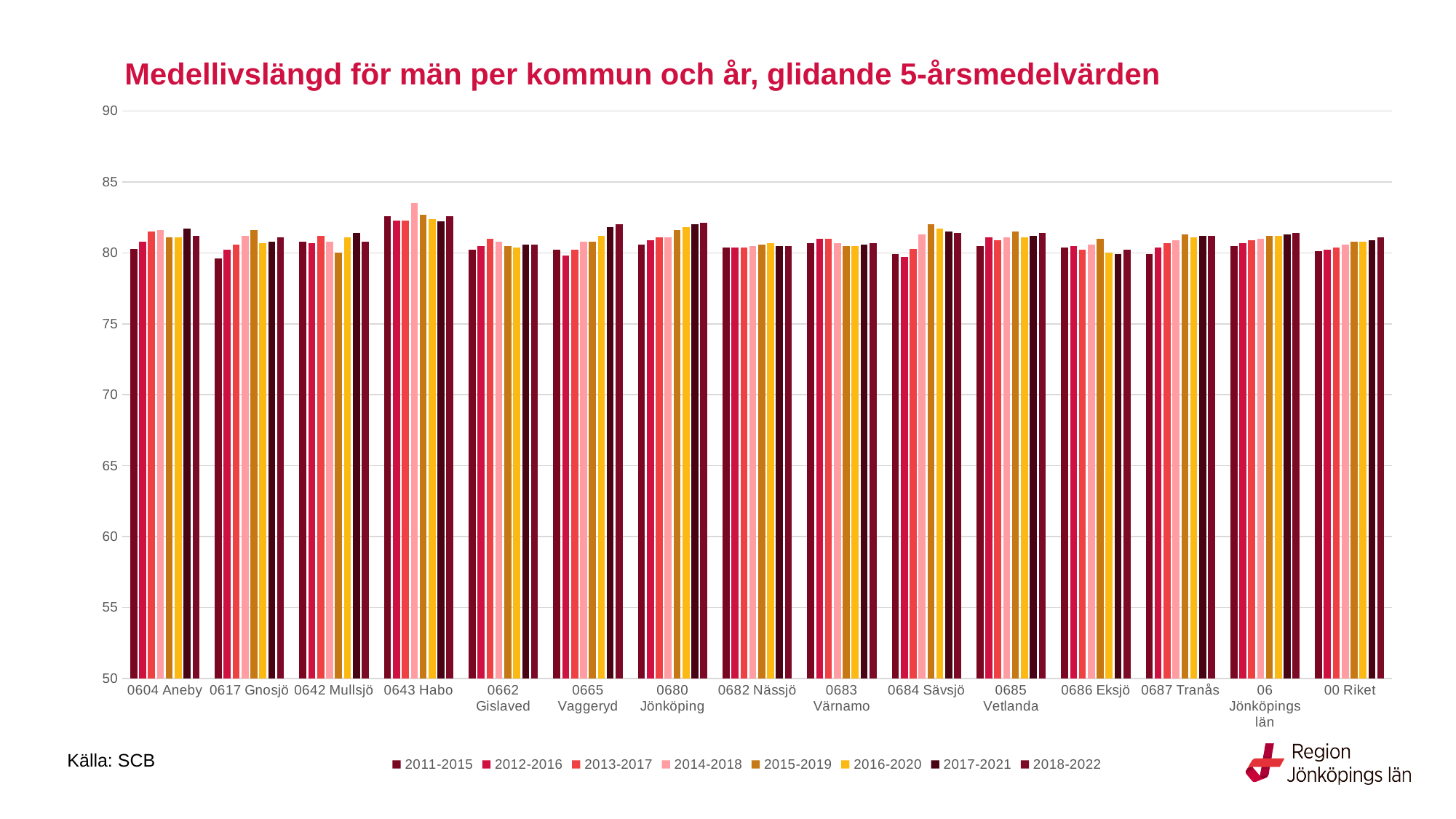
What source is cited for the chart data? SCB Which period has the tallest bar for 0643 Habo? 2014-2018 Which is larger: the value for 0643 Habo in 2014-2018 or the value for 0617 Gnosjö in 2011-2015? 0643 Habo in 2014-2018 Is the value for 0680 Jönköping in 2018-2022 greater or less than 85? less What kind of chart is shown on the slide? Bar chart What is the title of the chart? Medellivslängd för män per kommun och år, glidande 5-årsmedelvärden Is the value for 0643 Habo in 2014-2018 greater or less than 85? less Is the value for 0643 Habo in 2014-2018 greater or less than 80? greater Which municipality has the highest bars overall in the chart? 0643 Habo How many series does the legend list? 8 How many categories (municipalities/regions) are shown on the x axis? 15